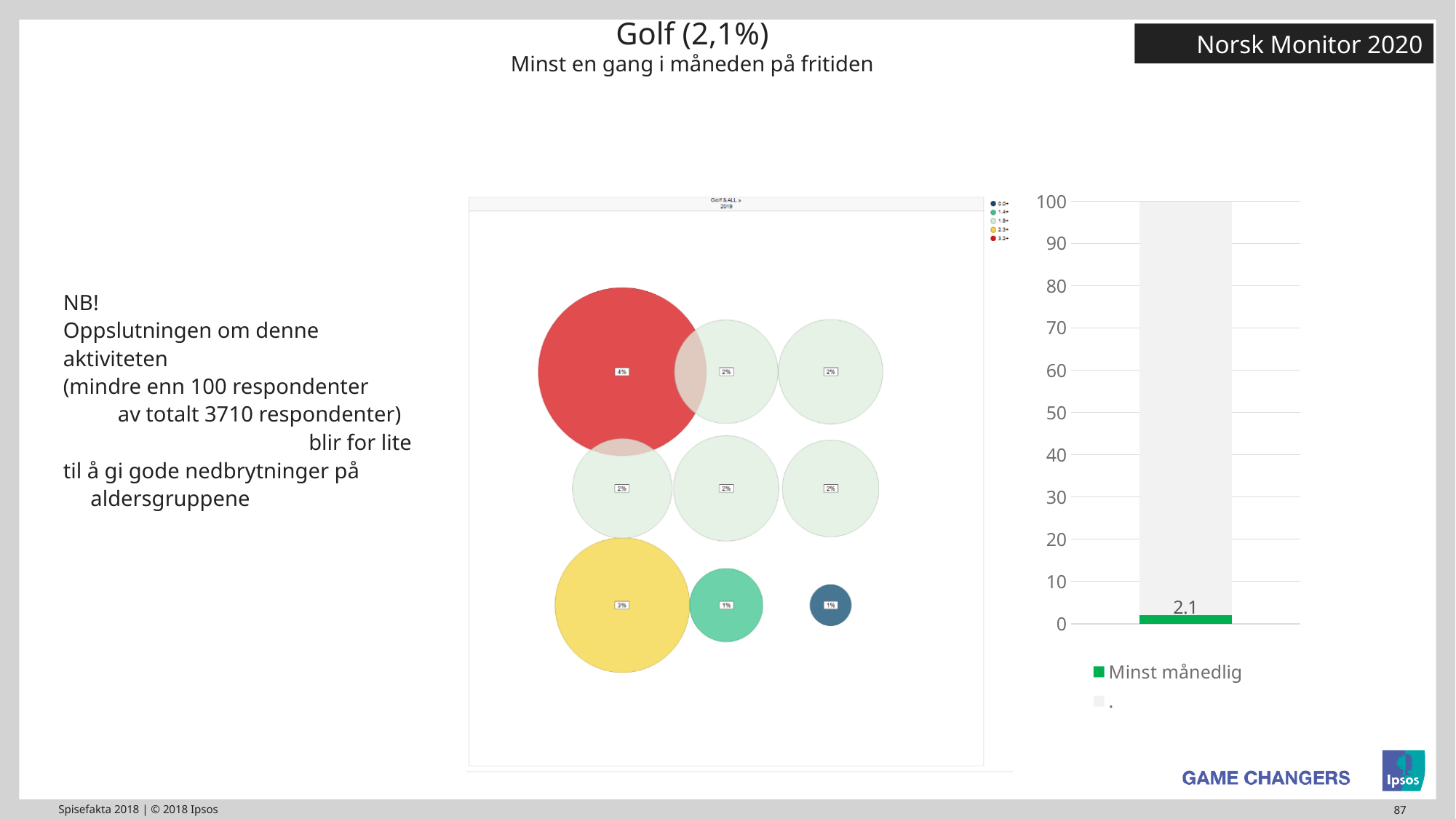
What kind of chart is shown on the right side of the slide? bar chart In the bar chart on the right, is the value for Minst månedlig greater or less than 10? less In the bubble chart in the middle of the slide, what value is labelled on the red bubble? 4% In the bubble chart in the middle of the slide, what value is labelled on the yellow bubble? 3% How many series does the legend of the bar chart on the right list? 2 In the bubble chart in the middle of the slide, what is the highest percentage label shown? 4% What is the first legend entry of the bar chart on the right? Minst månedlig How many bars does the bar chart on the right contain? 1 In the bar chart on the right, what is the value shown for Minst månedlig? 2.1 What is the highest value shown on the vertical axis of the bar chart on the right? 100 How many bubbles are shown in the bubble chart in the middle of the slide? 9 In the bubble chart in the middle of the slide, what is the lowest percentage label shown? 1%